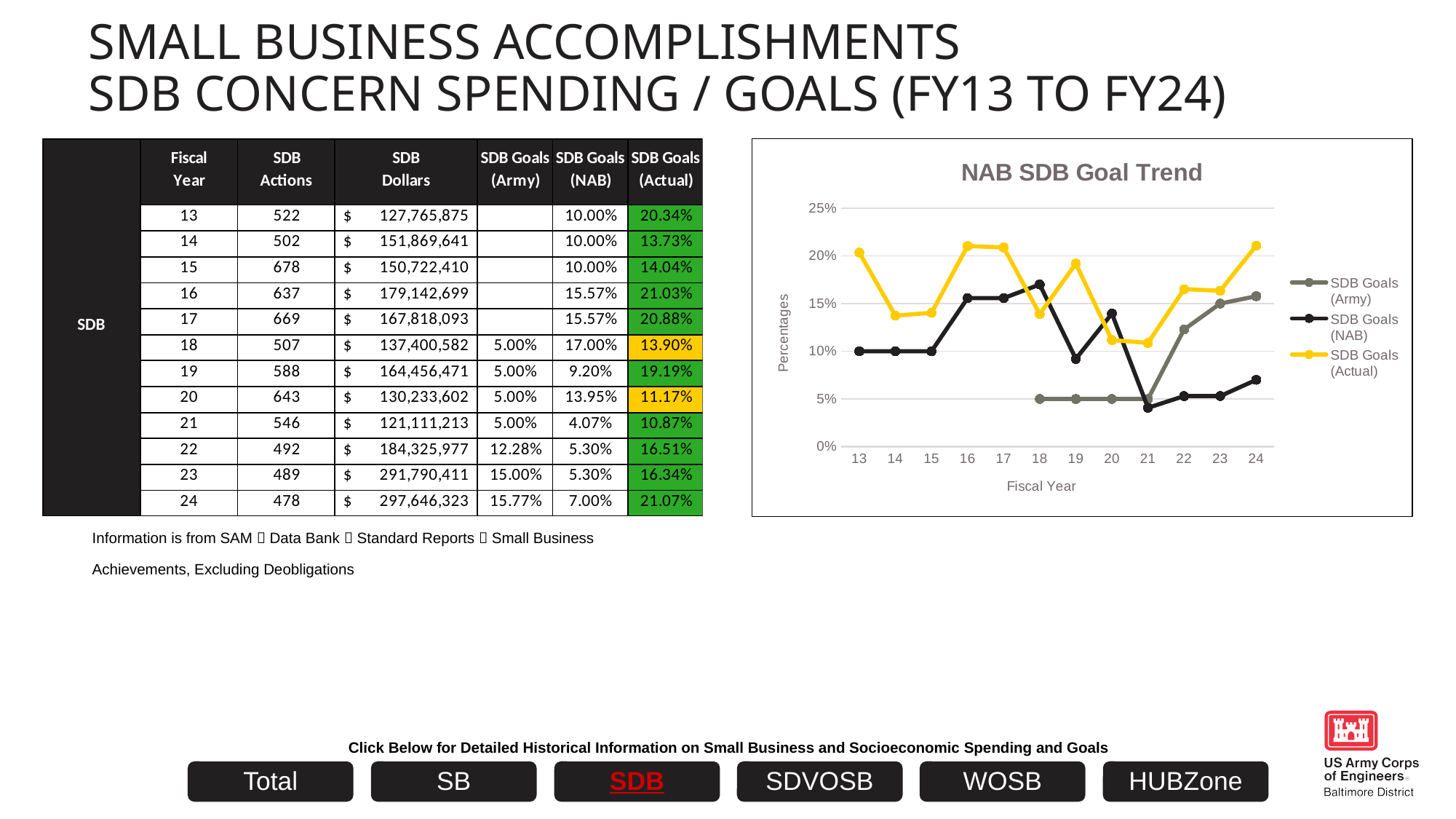
How many series does the legend of the NAB SDB Goal Trend chart list? 3 What is the SDB Goals (Army) value for fiscal year 22? 12.28% How many fiscal years are plotted along the x axis of the NAB SDB Goal Trend chart? 12 What is the SDB Goals (Actual) value for fiscal year 24? 21.07% What kind of chart is the NAB SDB Goal Trend chart? line chart In which fiscal year is the SDB Goals (NAB) value lowest? 21 Do the SDB Goals (Army) values rise or fall from fiscal year 21 to fiscal year 24? rise What is the SDB Goals (NAB) value for fiscal year 18? 17.00% What is the difference between SDB Goals (Actual) and SDB Goals (NAB) for fiscal year 24? 14.07% Is the SDB Goals (Actual) value for fiscal year 13 greater or less than 15%? greater In which fiscal year is the SDB Goals (NAB) value highest? 18 For fiscal year 19, which is larger: SDB Goals (Actual) or SDB Goals (NAB)? SDB Goals (Actual)